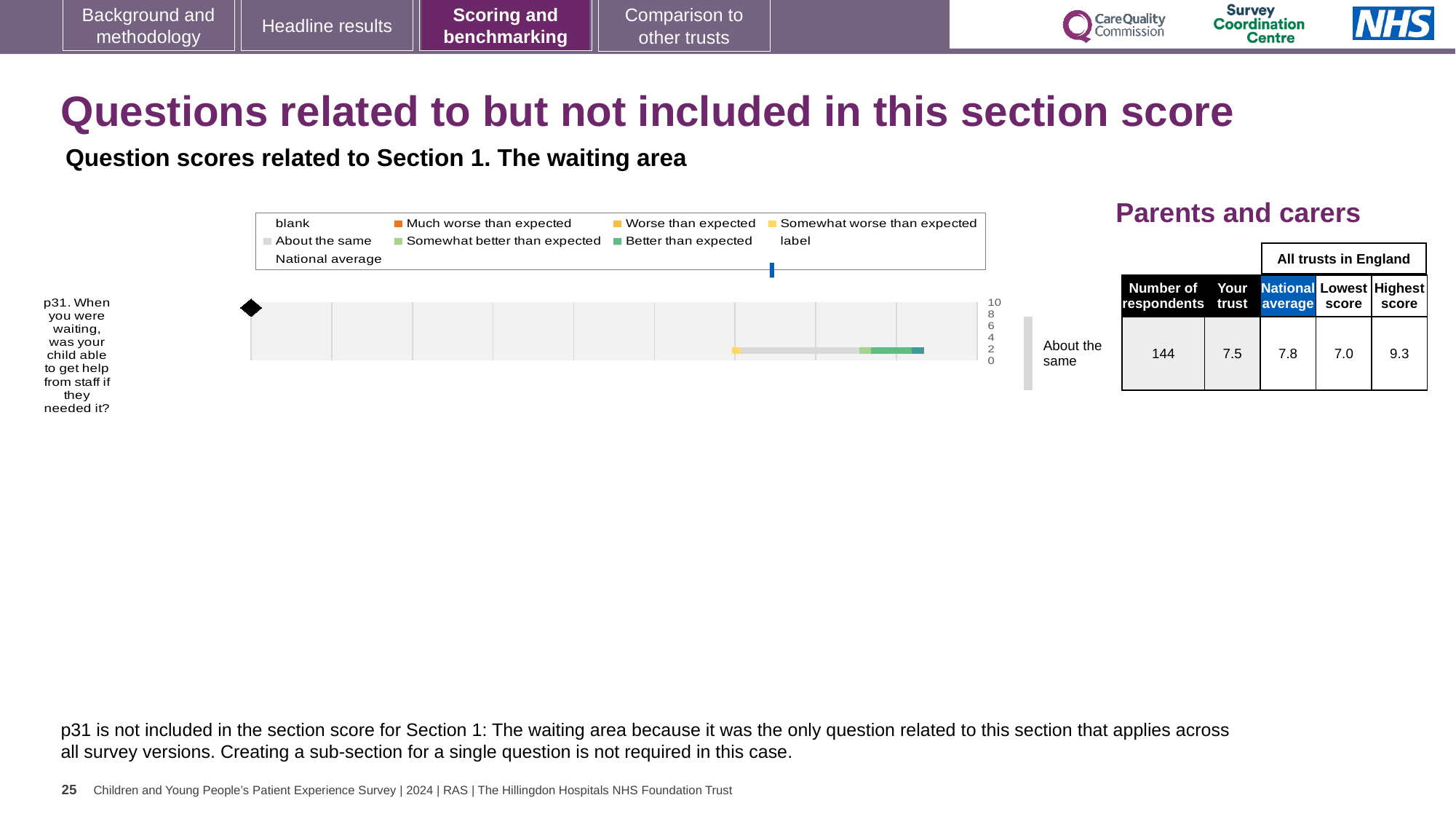
What is the difference between the national average and the 'Your trust' score for p31? 0.3 Is the 'Your trust' score for p31 higher or lower than the national average? lower In the Parents and carers table, what is the highest score among all trusts in England for p31? 9.3 In the Parents and carers table, what is the national average score for p31? 7.8 What is the difference between the highest score and the lowest score for p31 across all trusts in England? 2.3 How many respondents answered question p31? 144 What kind of chart is used to show the score for question p31? bar chart In the Parents and carers table, what is the lowest score among all trusts in England for p31? 7.0 How many survey questions are plotted in the chart? 1 In the Parents and carers table, what is the 'Your trust' score for p31? 7.5 What rating label is shown next to the bar for question p31? About the same Which section are the question scores in the chart related to? Section 1. The waiting area